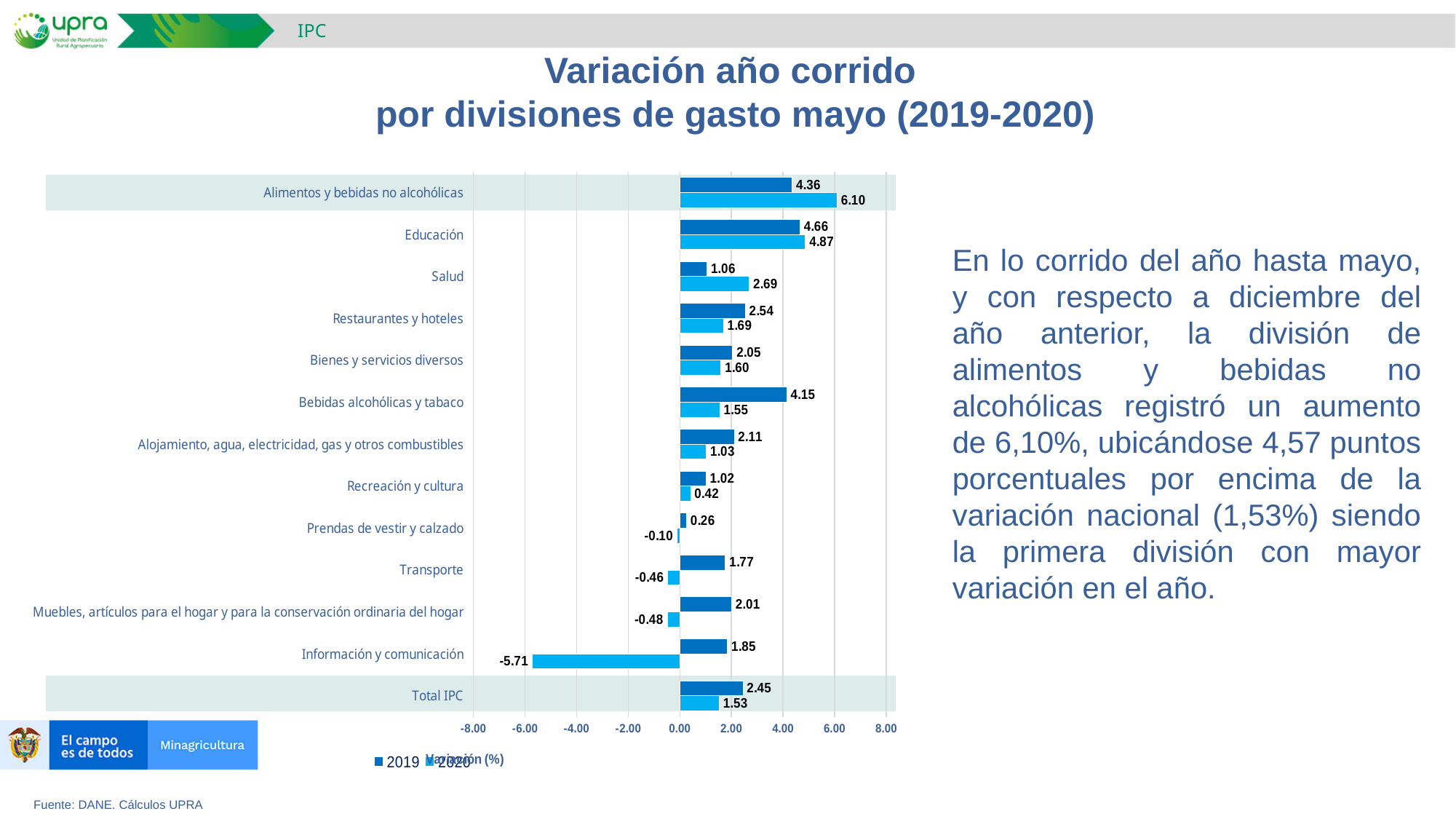
What is the 2019 value for Educación? 4.66 What is the 2020 value for Total IPC? 1.53 Which category has the highest 2019 value? Educación How many series does the legend list? 2 What is the 2020 value for Información y comunicación? -5.71 Which category has the lowest 2020 value? Información y comunicación What type of chart is shown on the slide? bar chart What is the 2020 value for Alimentos y bebidas no alcohólicas? 6.10 What is the difference between the 2020 and 2019 values for Salud? 1.63 Which category has the highest 2020 value? Alimentos y bebidas no alcohólicas For Bebidas alcohólicas y tabaco, which is larger, the 2019 value or the 2020 value? 2019 How many categories are shown on the chart? 13